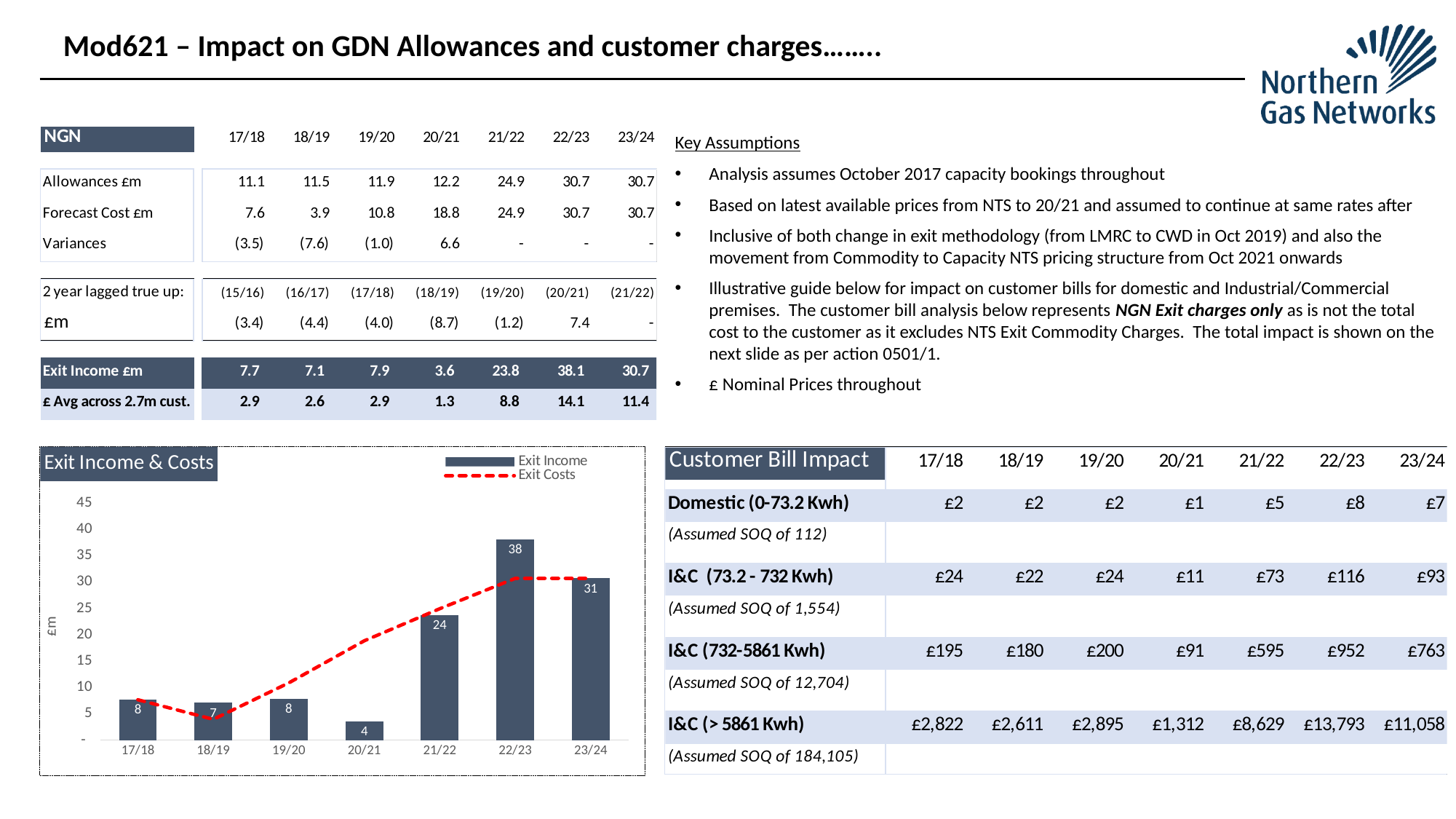
In the Exit Income & Costs chart, what kind of chart is used to show the Exit Income series? bar chart In the Exit Income & Costs chart, is the Exit Costs value for 18/19 greater or less than 10? less How many years are shown on the x axis of the Exit Income & Costs chart? 7 In the Exit Income & Costs chart, what is the difference between the Exit Income values for 22/23 and 23/24? 7 In the Exit Income & Costs chart, is the Exit Costs value for 20/21 greater or less than 15? greater How many series does the legend of the Exit Income & Costs chart list? 2 In the Exit Income & Costs chart, does the Exit Income rise or fall from 20/21 to 22/23? rise In the Exit Income & Costs chart, what is the Exit Income value for 22/23? 38 In the Exit Income & Costs chart, which year has the lowest Exit Income bar? 20/21 In the Exit Income & Costs chart, which year has the highest Exit Income bar? 22/23 In the Exit Income & Costs chart, which year has the larger Exit Income bar, 21/22 or 23/24? 23/24 In the Exit Income & Costs chart, what is the Exit Income value for 20/21? 4